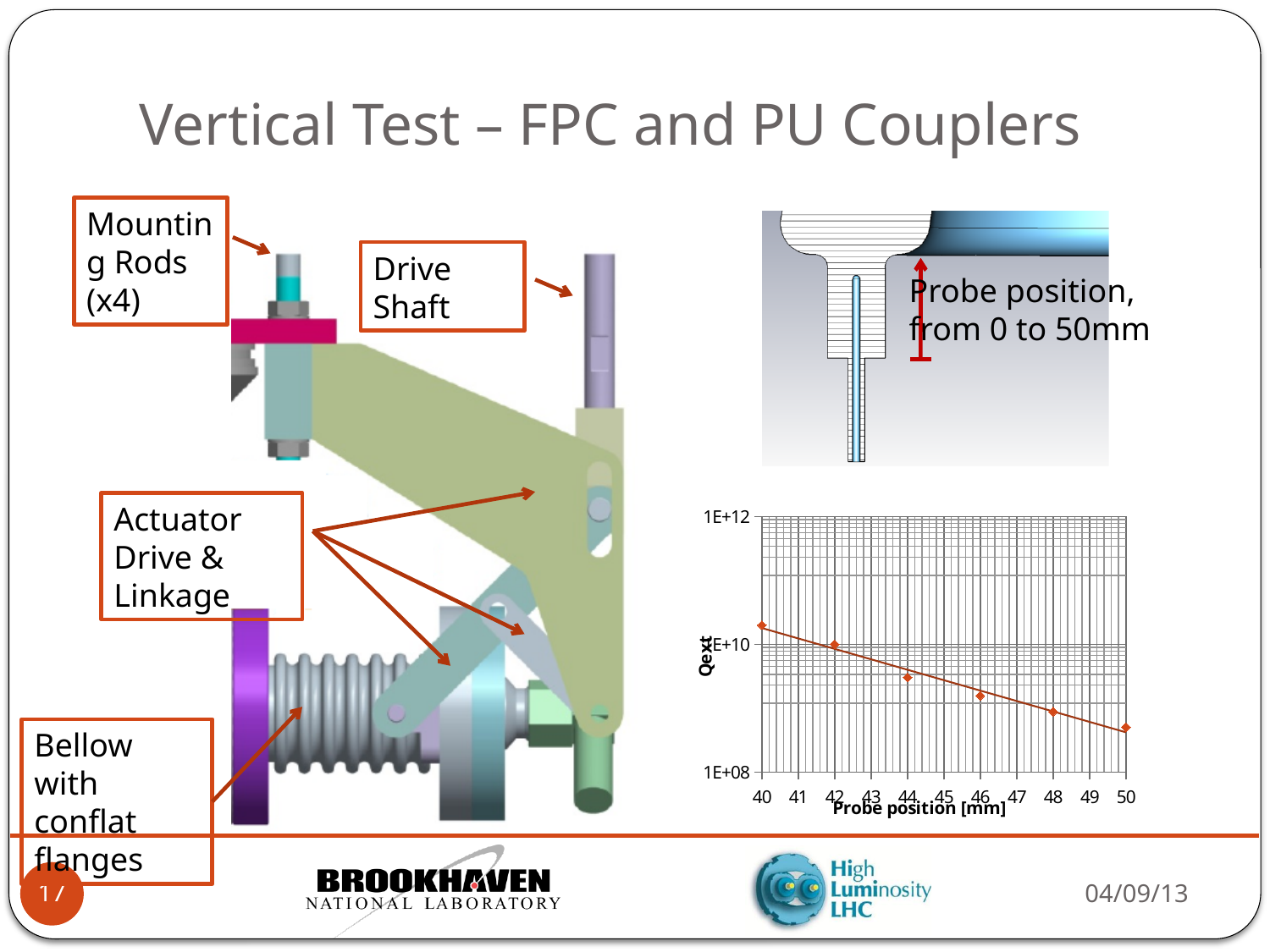
Is the Qext value at probe position 50 mm greater or less than 1E+10? less How many data points are plotted on the chart? 6 Is the Qext value at probe position 46 mm greater or less than 1E+10? less Is the Qext value at probe position 40 mm greater or less than 1E+10? greater Which probe position has the lowest Qext value? 50 What kind of chart is shown on the slide? scatter chart What is the label of the y axis of the chart? Qext Which probe position has the highest Qext value? 40 Which has the larger Qext value, probe position 44 mm or 48 mm? 44 What is the label of the x axis of the chart? Probe position [mm] Do the Qext values rise or fall as the probe position increases from 40 to 50 mm? fall